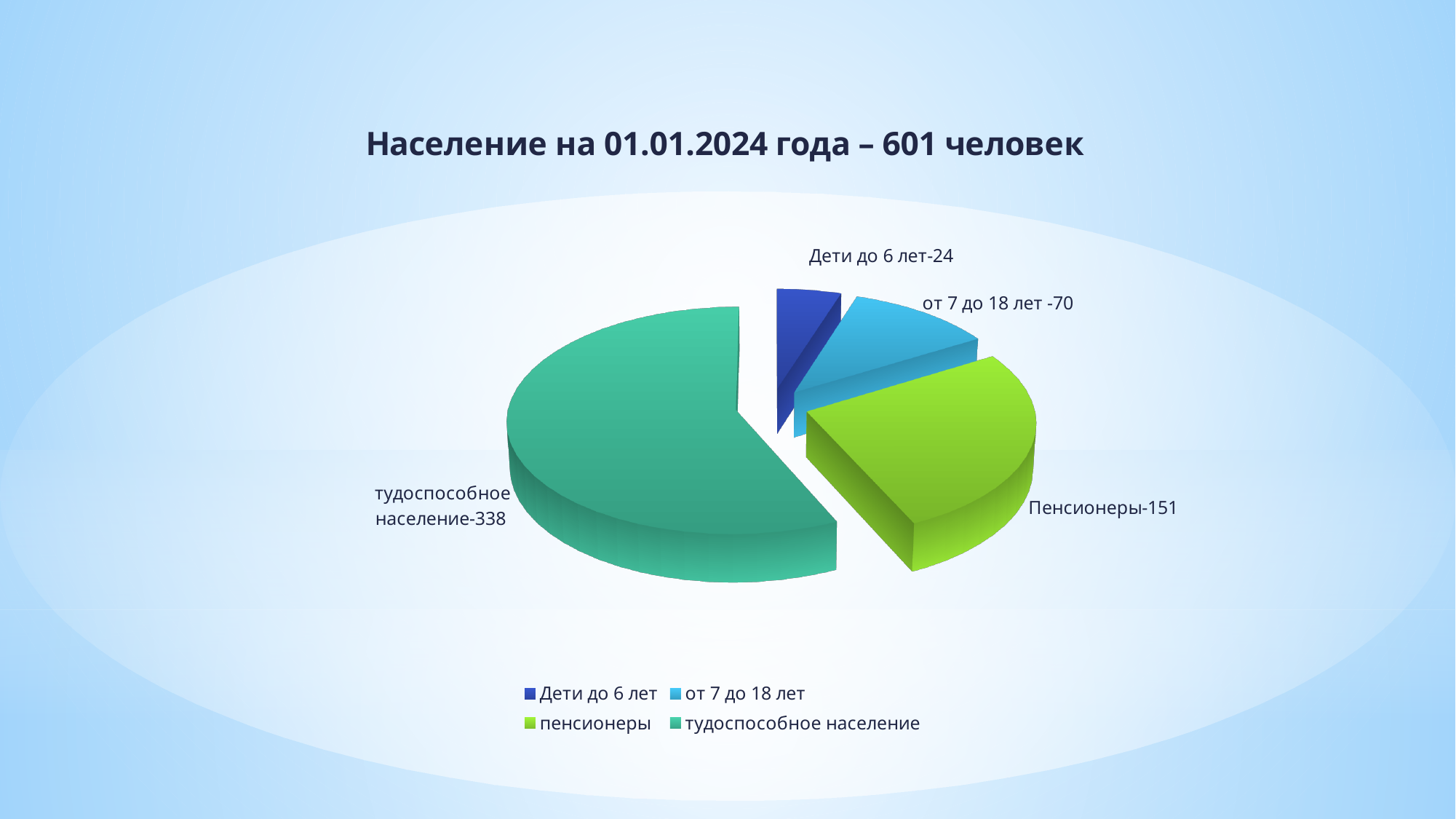
What is the value for "от 7 до 18 лет"? 70 Which category has the smallest slice? Дети до 6 лет What kind of chart is shown on the slide? Pie chart What is the difference between the values for "тудоспособное население" and "Пенсионеры"? 187 What is the difference between the values for "Пенсионеры" and "от 7 до 18 лет"? 81 How many categories does the pie chart have? 4 What is the value for "Дети до 6 лет"? 24 What is the value for "тудоспособное население"? 338 What is the value for "Пенсионеры"? 151 Which category has the largest slice? тудоспособное население Which is larger: the value for "от 7 до 18 лет" or the value for "Дети до 6 лет"? от 7 до 18 лет What is the title of the chart? Население на 01.01.2024 года – 601 человек